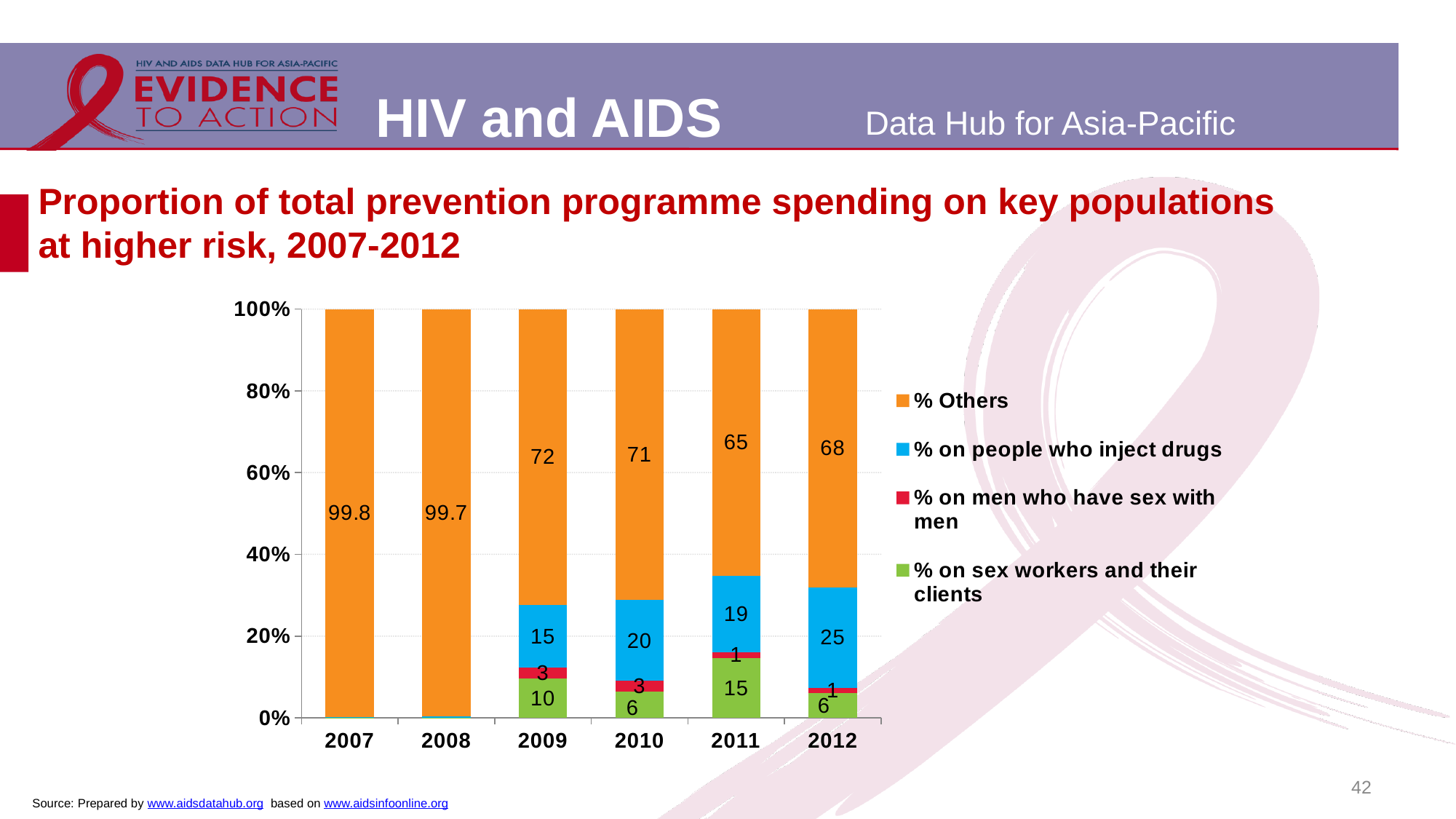
How many years are shown on the x axis? 6 What is the value for % on sex workers and their clients in 2011? 15 What is the difference between the % Others values for 2009 and 2012? 4 Among the years with a printed label, in which year is the value for % Others lowest? 2011 What is the value for % on people who inject drugs in 2012? 25 Which is larger, the % on sex workers and their clients value in 2009 or in 2010? 2009 What kind of chart is shown on the slide? Stacked bar chart In which year is the value for % on people who inject drugs highest? 2012 Which colour represents % Others in the chart? Orange What is the value for % Others in 2007? 99.8 How many series does the legend list? 4 What is the value for % on men who have sex with men in 2010? 3